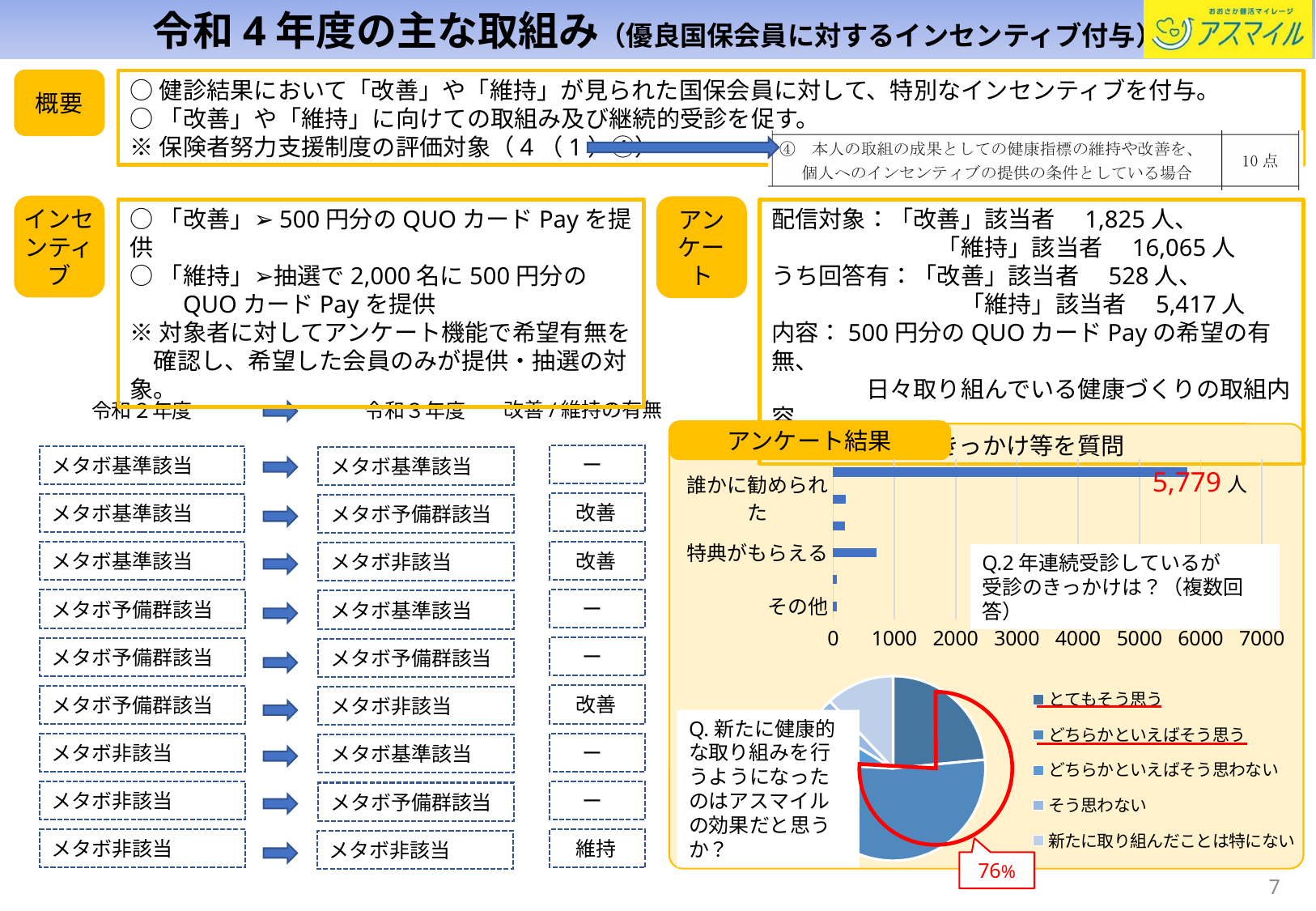
In the bar chart in the lower right, which is larger, the value for 特典がもらえる or the value for その他? 特典がもらえる In the bar chart in the lower right, is the value for 特典がもらえる greater or less than 1000? less In the bar chart in the lower right, what value is printed as a data label on the longest bar? 5,779人 In the bar chart in the lower right, is the value for その他 greater or less than 1000? less In the bar chart in the lower right, is the value of the longest bar greater or less than 5000? greater In the pie chart at the bottom right, what percentage is shown in the red callout for the slices outlined in red? 76% What kind of chart is the chart in the lower right showing reasons for receiving a checkup? bar chart In the bar chart in the lower right, what is the highest tick value shown on the horizontal axis? 7000 What kind of chart is the chart at the bottom right about whether new health initiatives are an effect of アスマイル? pie chart How many entries does the legend of the pie chart at the bottom right list? 5 In the pie chart at the bottom right, which two legend entries are underlined in red? とてもそう思う and どちらかといえばそう思う